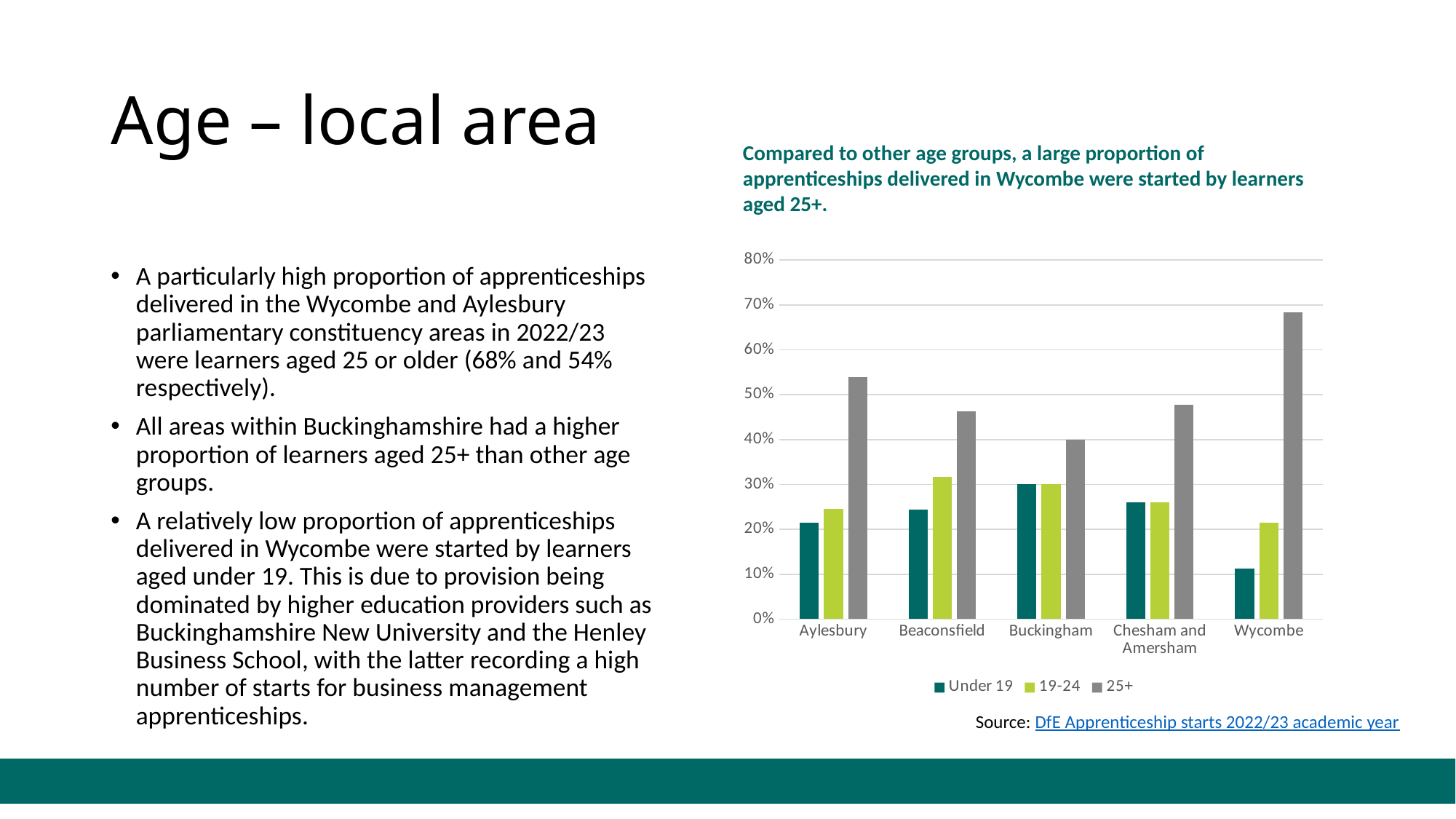
How many local areas are shown on the x axis of the chart? 5 How many series does the chart legend list? 3 Is the value for the 25+ series in Wycombe greater or less than 60%? greater Which local area has the highest value for the Under 19 series? Buckingham Which is larger: the 25+ value for Aylesbury or the 25+ value for Beaconsfield? Aylesbury Which local area has the highest value for the 25+ series? Wycombe What are the three age groups listed in the chart legend? Under 19, 19-24, 25+ Is the value for the 25+ series in Buckingham greater or less than 50%? less Is the value for the 25+ series in Aylesbury greater or less than 50%? greater Which local area has the lowest value for the Under 19 series? Wycombe What kind of chart is shown on the slide? Bar chart